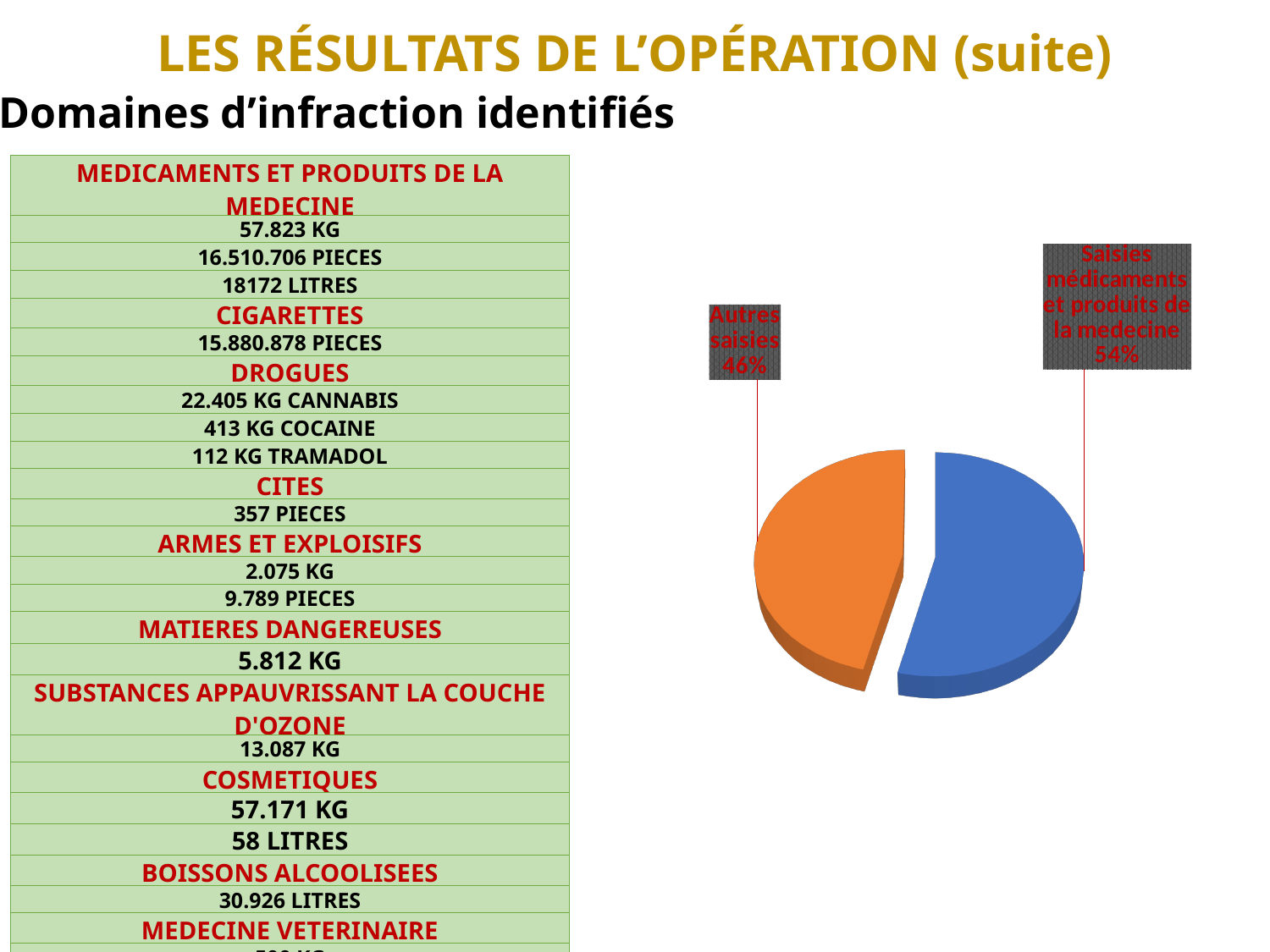
What share of the pie does "Autres saisies" represent? 46% What colour is the "Saisies médicaments et produits de la medecine" slice in the pie chart? blue Which is larger in the pie chart: "Autres saisies" or "Saisies médicaments et produits de la medecine"? Saisies médicaments et produits de la medecine What share of the pie does "Saisies médicaments et produits de la medecine" represent? 54% What colour is the "Autres saisies" slice in the pie chart? orange What kind of chart is shown on the slide? pie chart Which slice of the pie chart is the largest? Saisies médicaments et produits de la medecine How many slices does the pie chart have? 2 Which slice of the pie chart is the smallest? Autres saisies What is the difference in percentage points between the "Saisies médicaments et produits de la medecine" slice and the "Autres saisies" slice? 8 Is the share for "Autres saisies" greater or less than 50%? less